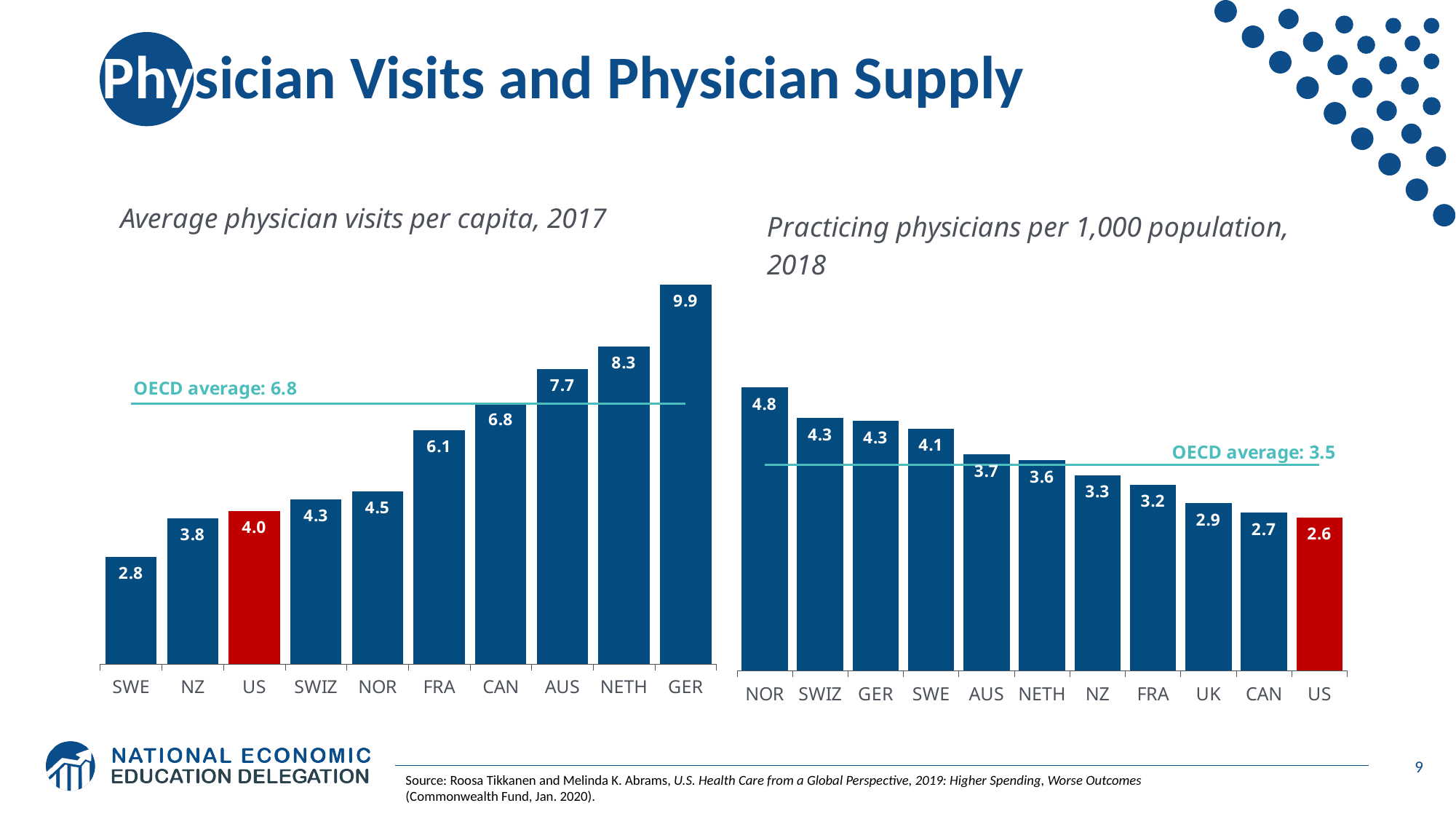
In the 'Practicing physicians per 1,000 population, 2018' chart, what is the difference between SWE and CAN? 1.4 In the 'Practicing physicians per 1,000 population, 2018' chart, which country has the lowest value? US What type of chart is used for 'Average physician visits per capita, 2017'? Bar chart In the 'Practicing physicians per 1,000 population, 2018' chart, what OECD average is marked by the horizontal line? 3.5 In the 'Practicing physicians per 1,000 population, 2018' chart, how many countries are shown? 11 In the 'Average physician visits per capita, 2017' chart, what is the value for the US? 4.0 In the 'Average physician visits per capita, 2017' chart, how many countries are shown? 10 In the 'Practicing physicians per 1,000 population, 2018' chart, what is the value for NOR? 4.8 In the 'Average physician visits per capita, 2017' chart, which country has the highest value? GER In the 'Average physician visits per capita, 2017' chart, which country has the lowest value? SWE In the 'Average physician visits per capita, 2017' chart, what is the difference between GER and the US? 5.9 In the 'Practicing physicians per 1,000 population, 2018' chart, which is larger, the value for NETH or the value for UK? NETH